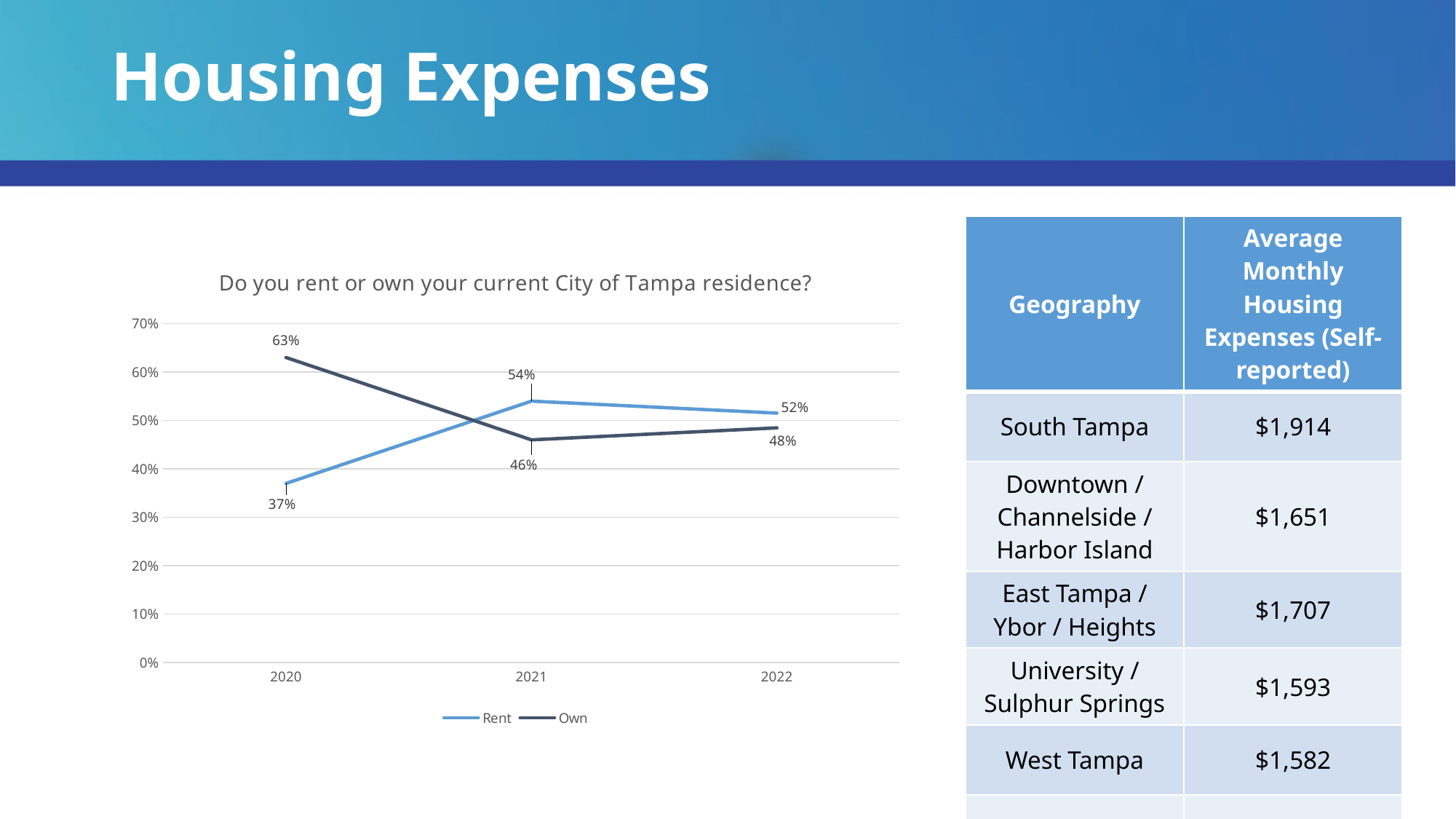
What kind of chart is shown? Line chart Is the Own value for 2020 greater or less than 60%? greater In which year was the Own series highest? 2020 What is the difference between the Own and Rent values in 2020? 26% How many series does the legend list? 2 What is the Rent value for 2022? 52% What percentage of respondents rented in 2020? 37% Does the Own series rise or fall from 2020 to 2021? Fall In which year was the Rent series lowest? 2020 What percentage of respondents owned their residence in 2021? 46% Which was larger in 2022, Rent or Own? Rent How many years are shown on the x axis? 3